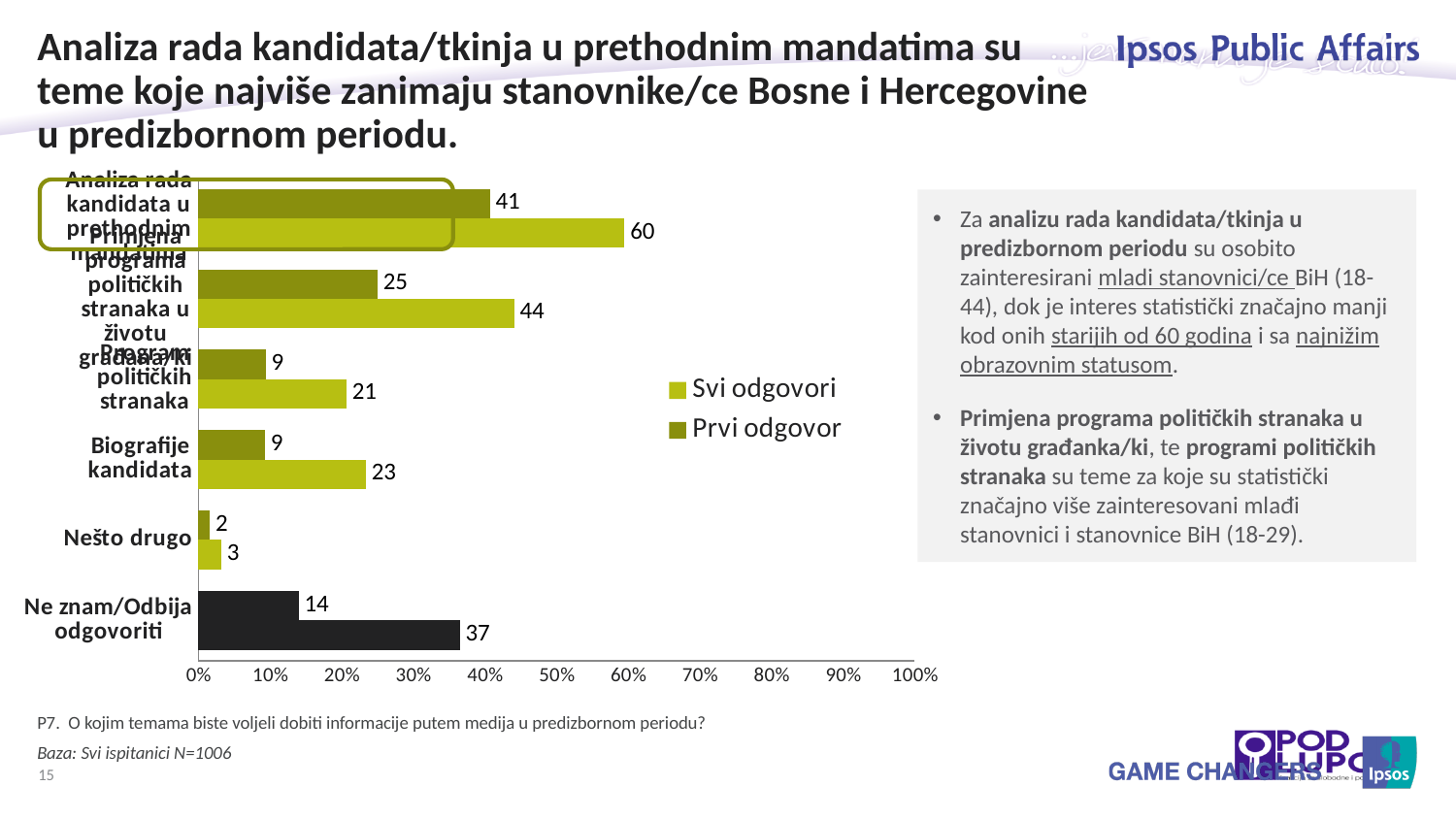
What is the difference between the Svi odgovori and Prvi odgovor values for Ne znam/Odbija odgovoriti? 23 What type of chart is shown on the slide? bar chart Which is larger for Biografije kandidata: the Svi odgovori value or the Prvi odgovor value? Svi odgovori What is the Prvi odgovor value for Biografije kandidata? 9 What are the two series named in the chart legend? Svi odgovori and Prvi odgovor What is the Svi odgovori value for Ne znam/Odbija odgovoriti? 37 Is the Svi odgovori value for Ne znam/Odbija odgovoriti greater or less than 30%? greater What is the Svi odgovori value for Biografije kandidata? 23 Which category has the lowest Svi odgovori value? Nešto drugo What is the highest Svi odgovori value shown in the chart? 60 What is the Prvi odgovor value for Nešto drugo? 2 How many series does the chart legend list? 2